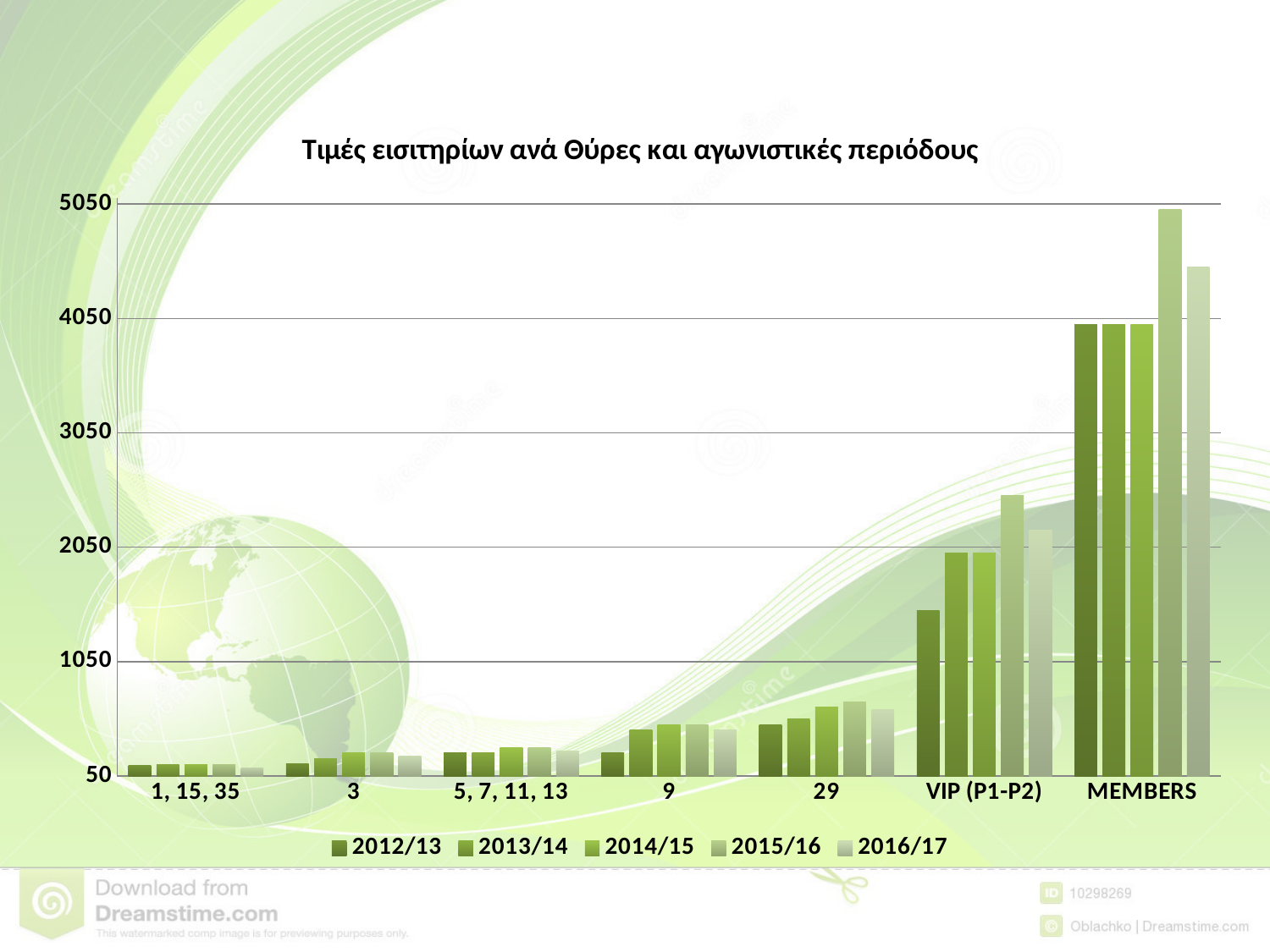
Do the bar heights generally rise or fall moving from left to right across the categories? rise Is the 2012/13 value for VIP (P1-P2) greater or less than 1050? greater What is the title of the chart? Τιμές εισιτηρίων ανά Θύρες και αγωνιστικές περιόδους Which category has the lowest bars? 1, 15, 35 For VIP (P1-P2), which is larger: the 2015/16 value or the 2016/17 value? 2015/16 Is the 2015/16 value for VIP (P1-P2) greater or less than 2050? greater How many series does the legend list? 5 What kind of chart is shown on the slide? bar chart How many categories are shown on the x axis? 7 Is the 2015/16 value for MEMBERS greater or less than 4050? greater Which category has the highest bars? MEMBERS